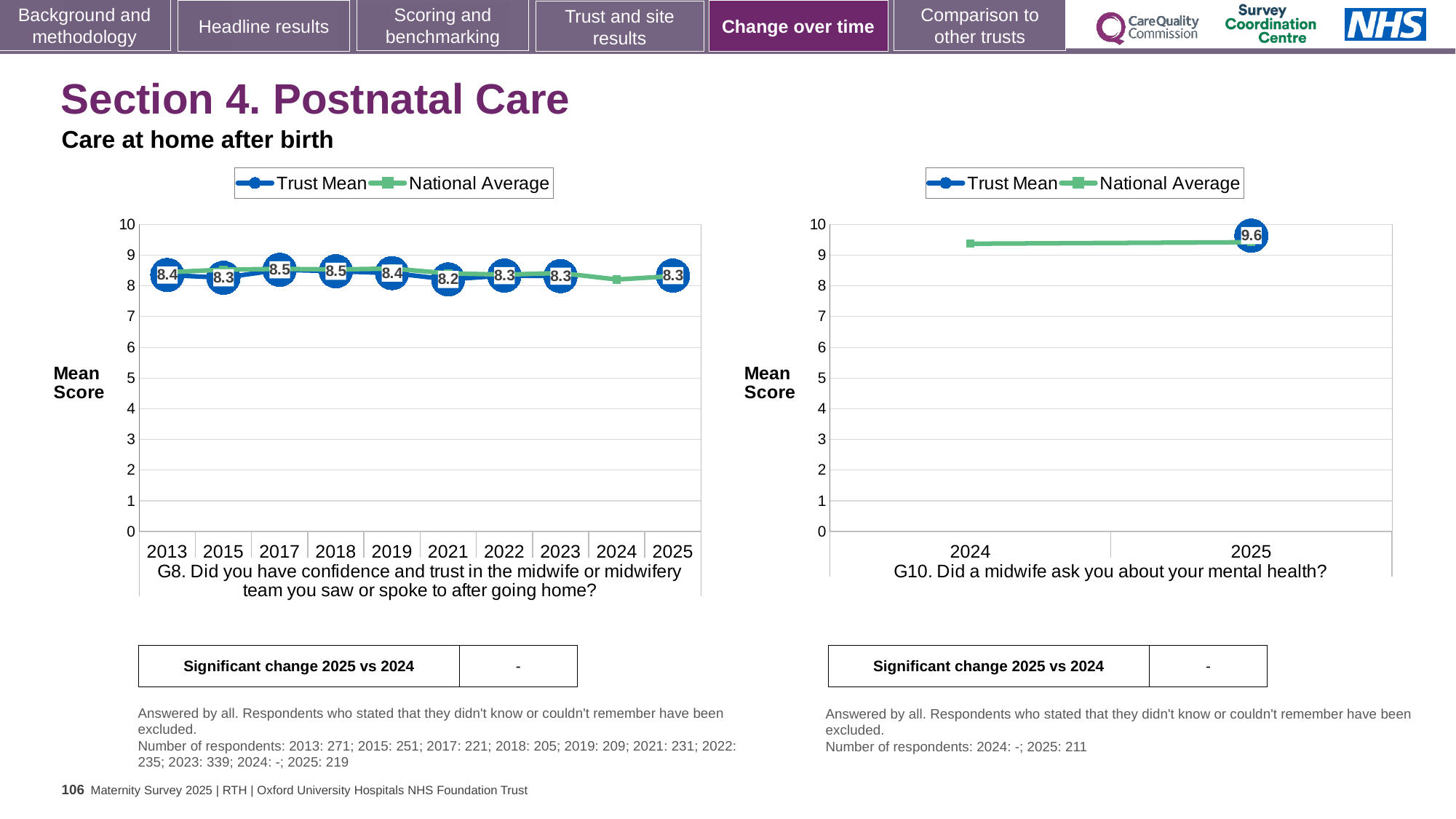
In the right chart (G10), is the National Average for 2024 greater or less than 9? greater In the left chart (G8), what is the Trust Mean for 2017? 8.5 In the left chart (G8), which is larger, the Trust Mean for 2017 or the Trust Mean for 2021? 2017 In the left chart (G8), does the Trust Mean rise or fall from 2018 to 2021? fall In the left chart (G8), what is the difference between the Trust Mean for 2018 and the Trust Mean for 2021? 0.3 In the left chart (G8), how many years are shown on the x axis? 10 What kind of chart is the left chart (G8)? line chart In the right chart (G10), what is the Trust Mean for 2025? 9.6 How many series does the legend of the left chart (G8) list? 2 In the left chart (G8), is the National Average for 2024 greater or less than 9? less In the left chart (G8), what is the Trust Mean for 2021? 8.2 In the left chart (G8), which year has the lowest Trust Mean? 2021